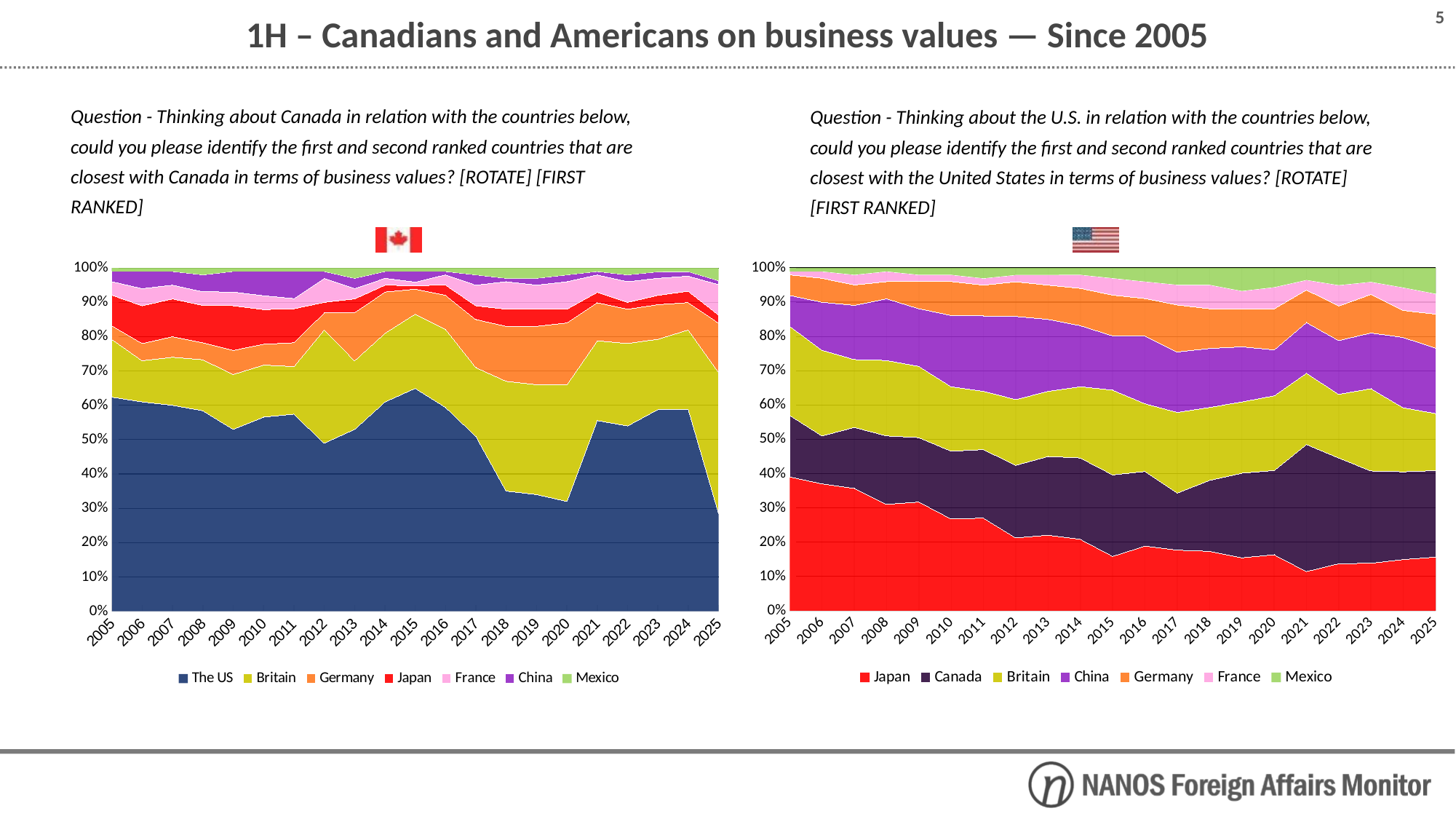
How many series does the legend of the left chart (Canada) list? 7 In the right chart (U.S.), is the value for Japan in 2005 greater or less than 30%? greater In the right chart (U.S.), is the value for Japan in 2021 greater or less than 20%? less What kind of chart is the left chart (Canada)? stacked area chart In the right chart (U.S.), does the share for Japan rise or fall overall from 2005 to 2025? fall In the left chart (Canada), is the value for The US in 2005 greater or less than 50%? greater How many series does the legend of the right chart (U.S.) list? 7 In the left chart (Canada), which series is plotted at the bottom of the stack? The US In the left chart (Canada), does the share for The US rise or fall overall from 2005 to 2025? fall How many years are shown on the x axis of the right chart (U.S.)? 21 In the right chart (U.S.), which series has the largest share in 2005? Japan